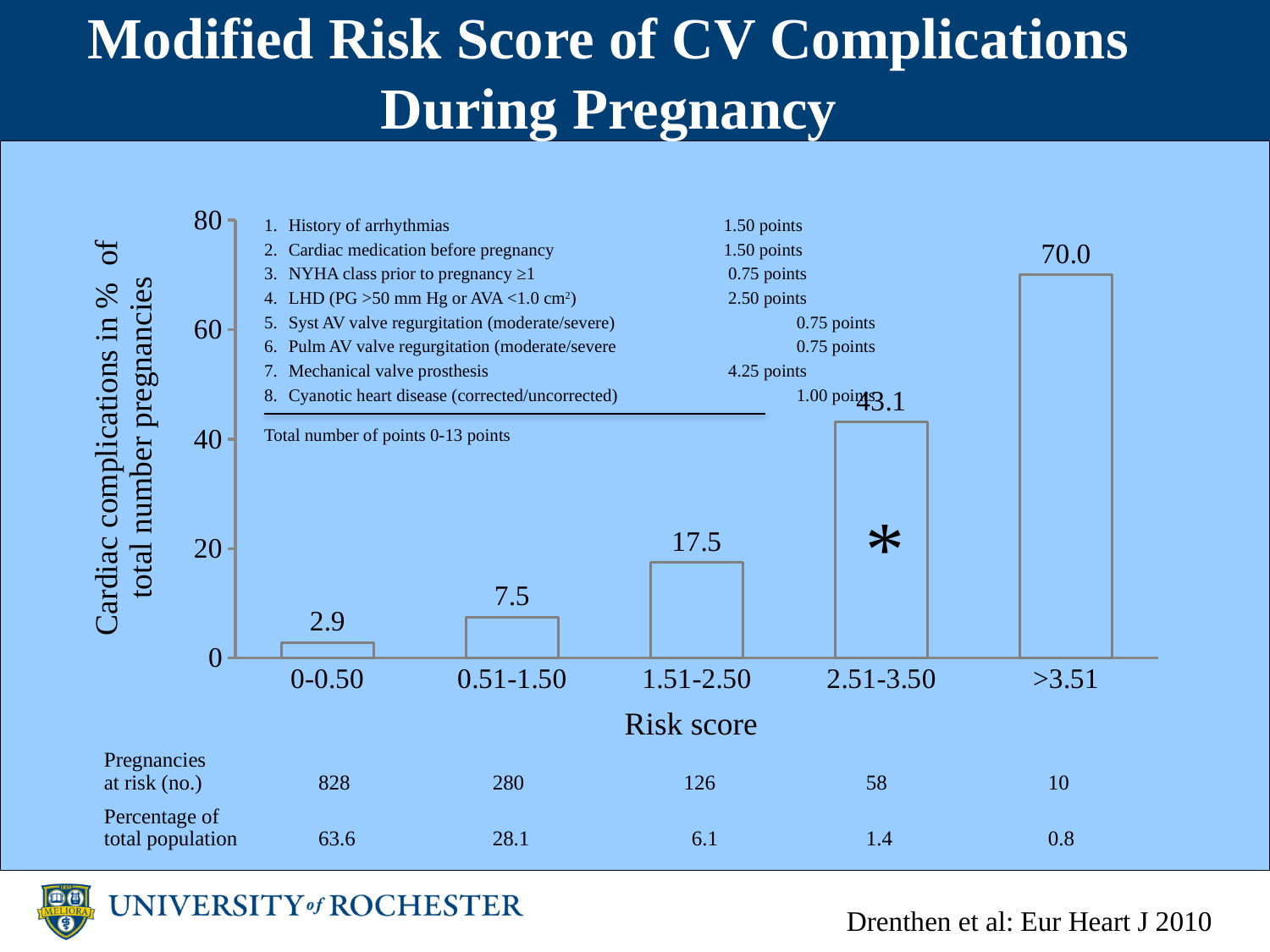
How many risk score categories are shown on the x axis? 5 Is the value for the 2.51-3.50 category greater or less than 40? greater What kind of chart is shown on the slide? bar chart Which risk score category has the lowest percentage of cardiac complications? 0-0.50 What is the value for the 0-0.50 risk score category? 2.9 Do the values rise or fall as the risk score increases along the x axis? rise Which risk score category has the highest percentage of cardiac complications? >3.51 What is the value for the >3.51 risk score category? 70.0 What is the difference between the values for the 1.51-2.50 and 0.51-1.50 categories? 10.0 Which is larger, the value for 0.51-1.50 or the value for 1.51-2.50? 1.51-2.50 What is the difference between the values for the >3.51 and 2.51-3.50 categories? 26.9 What is the value for the 1.51-2.50 risk score category? 17.5